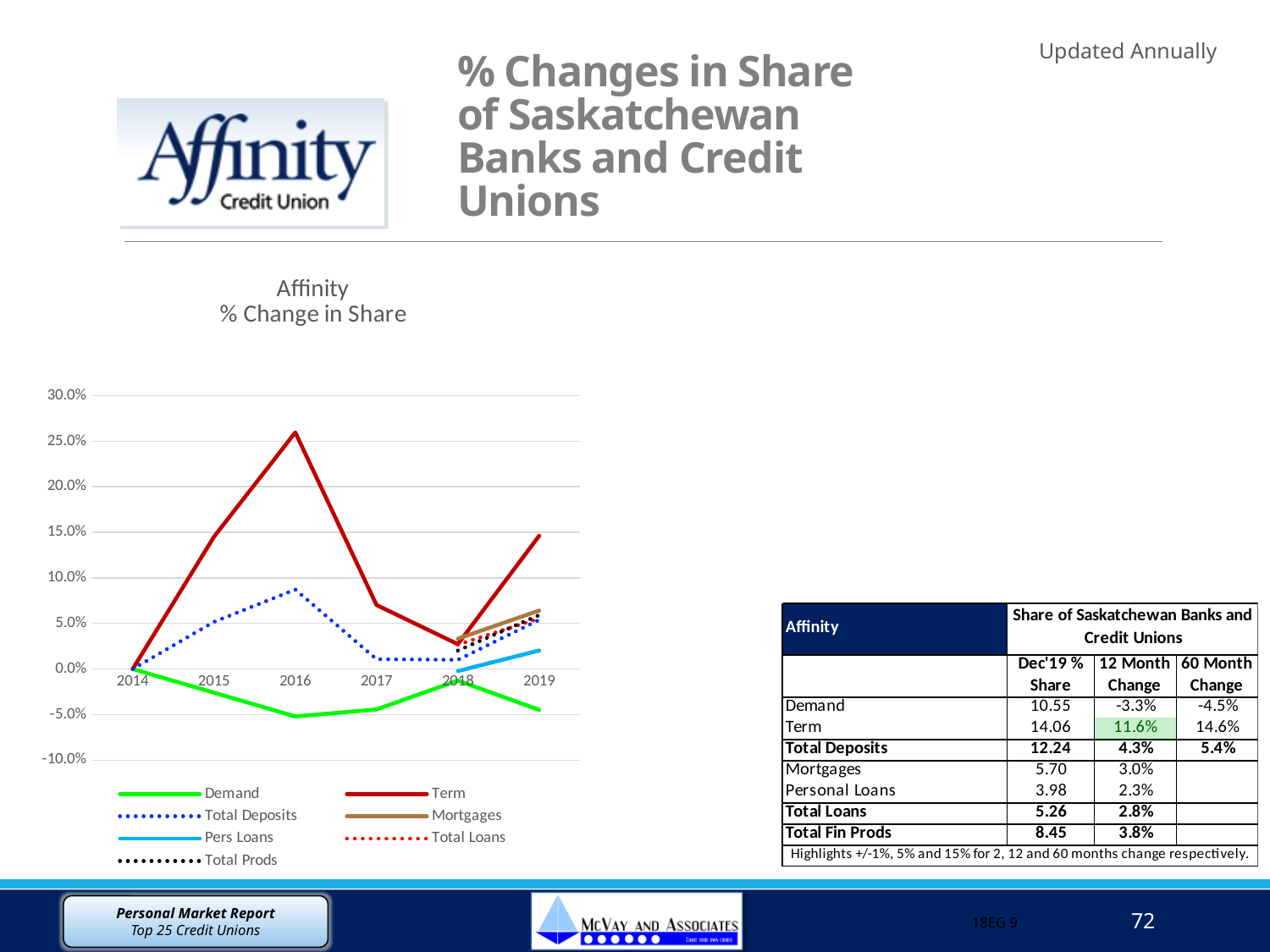
Is the value for Total Deposits in 2016 greater or less than 5.0%? greater What is the title of the chart? Affinity % Change in Share How many years are shown along the x axis of the chart? 6 How many series does the chart legend list? 7 Which series has the lowest value in 2019? Demand Is the value for Term in 2019 greater or less than 10.0%? greater Which series reaches the highest value in 2016? Term In 2019, which is larger, the value for Term or the value for Demand? Term Does the Term series rise or fall from 2016 to 2017? fall What kind of chart is shown on the slide? line chart Is the value for Demand in 2016 greater or less than 0.0%? less